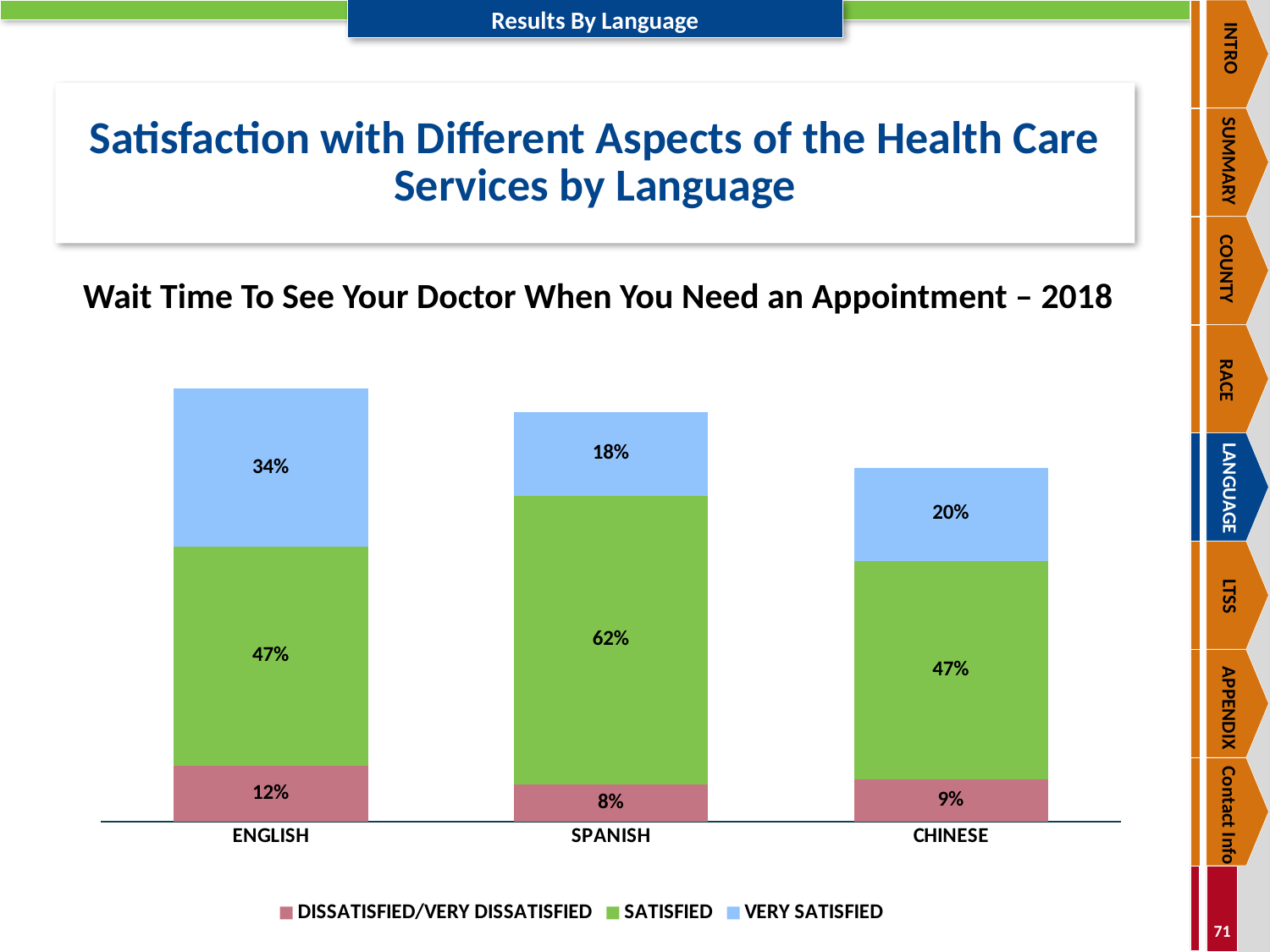
What kind of chart is shown on the slide? Stacked bar chart How many series does the legend list? 3 What is the total of the stacked bar for English? 93% What is the Very Satisfied value for English? 34% What is the Dissatisfied/Very Dissatisfied value for Chinese? 9% What is the difference between the Satisfied values for Spanish and Chinese? 15% What colour represents the Satisfied series in the legend? Green What is the Satisfied value for Spanish? 62% How many language categories are shown on the x axis? 3 Which language has the lowest Dissatisfied/Very Dissatisfied value? Spanish Which language has the highest Very Satisfied value? English Which is larger, the Very Satisfied value for Chinese or for Spanish? Chinese